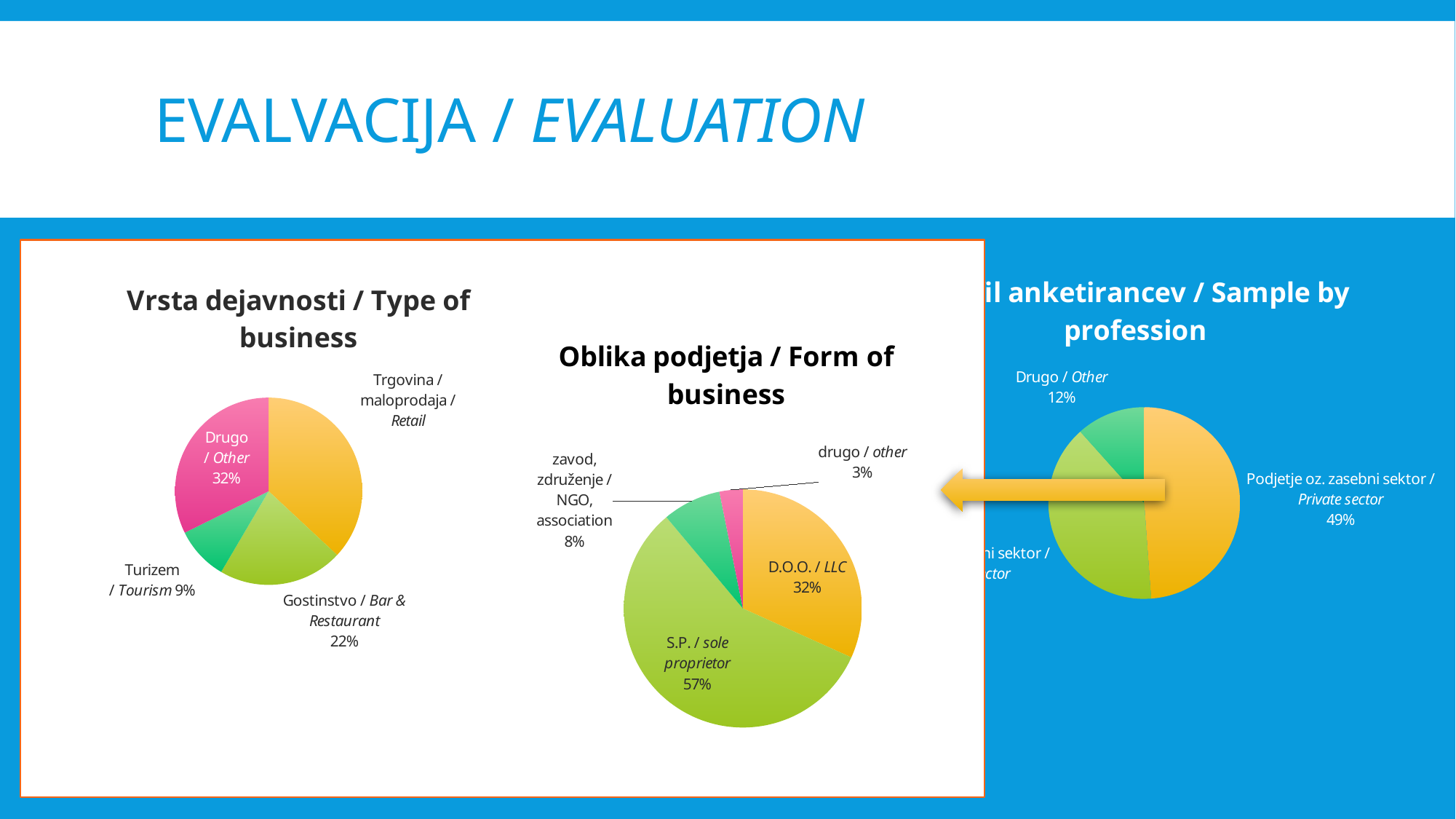
In the 'Vrsta dejavnosti / Type of business' chart, which is larger: Drugo / Other or Gostinstvo / Bar & Restaurant? Drugo / Other In the 'Vrsta dejavnosti / Type of business' chart, what percentage is shown for Turizem / Tourism? 9% In the 'Oblika podjetja / Form of business' chart, which category has the smallest slice? drugo / other In the 'Sample by profession' chart on the right, what percentage is shown for Podjetje oz. zasebni sektor / Private sector? 49% In the 'Vrsta dejavnosti / Type of business' chart, how many percentage points larger is Drugo / Other than Turizem / Tourism? 23 percentage points How many slices does the 'Oblika podjetja / Form of business' pie chart have? 4 In the 'Oblika podjetja / Form of business' chart, which category has the largest slice? S.P. / sole proprietor In the 'Oblika podjetja / Form of business' chart, what percentage is shown for D.O.O. / LLC? 32% In the 'Oblika podjetja / Form of business' chart, how many percentage points larger is S.P. / sole proprietor than D.O.O. / LLC? 25 percentage points In the 'Oblika podjetja / Form of business' chart, what percentage is shown for S.P. / sole proprietor? 57% What type of chart is used for 'Vrsta dejavnosti / Type of business'? Pie chart In the 'Vrsta dejavnosti / Type of business' chart, what percentage is shown for Gostinstvo / Bar & Restaurant? 22%